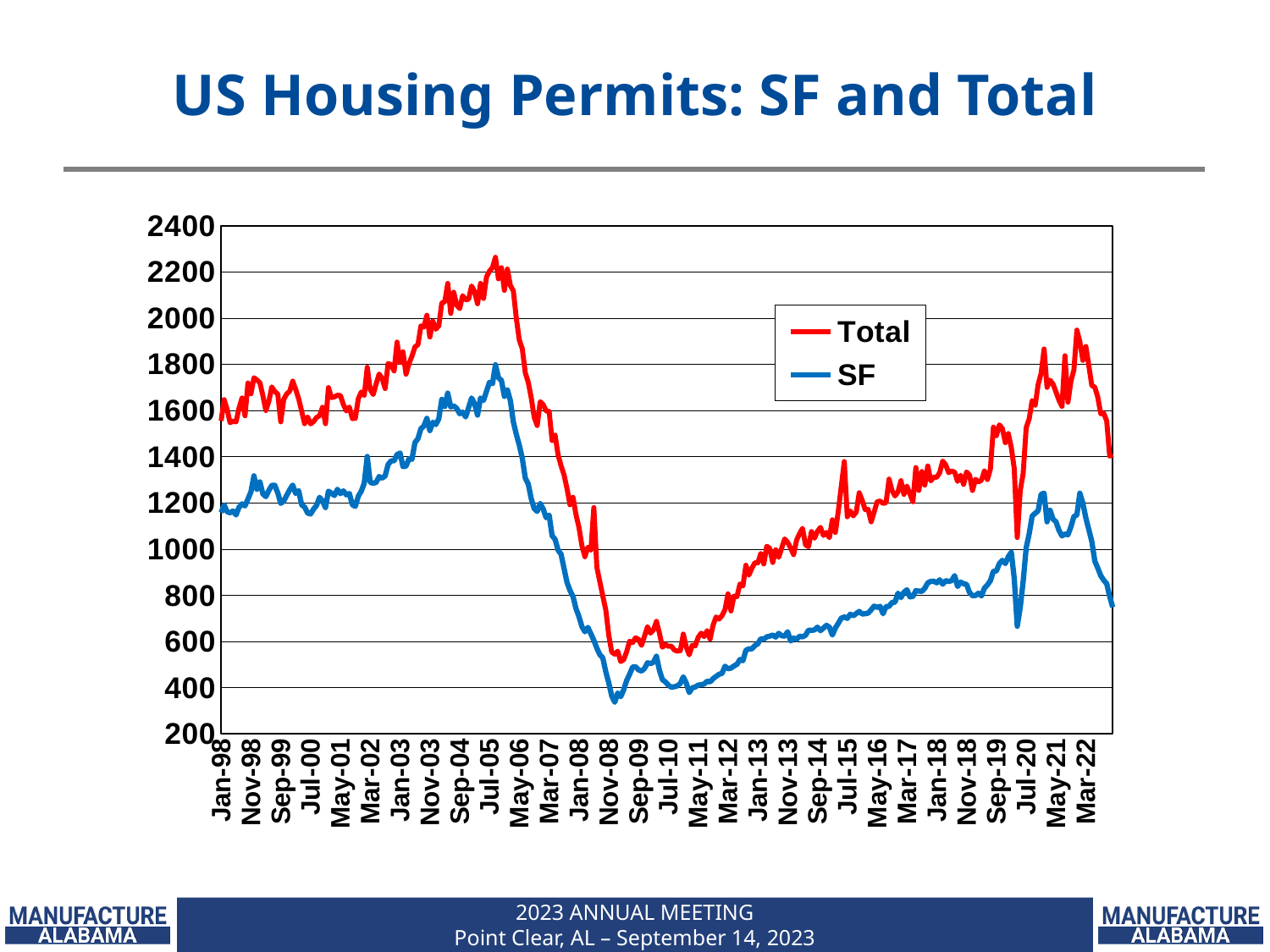
How many series does the legend list? 2 What is the title of the chart? US Housing Permits: SF and Total Is the value of the Total series around Nov-08 greater or less than 800? less Is the value of the SF series at Jan-98 greater or less than 1000? greater Does the Total series rise or fall between Jul-05 and Nov-08? fall Is the value of the Total series at its peak around Jul-05 greater or less than 2000? greater Does the SF series rise or fall between May-11 and Jan-18? rise Which colour is used for the SF series? blue What kind of chart is shown on the slide? line chart Which series is higher at Jul-05, Total or SF? Total